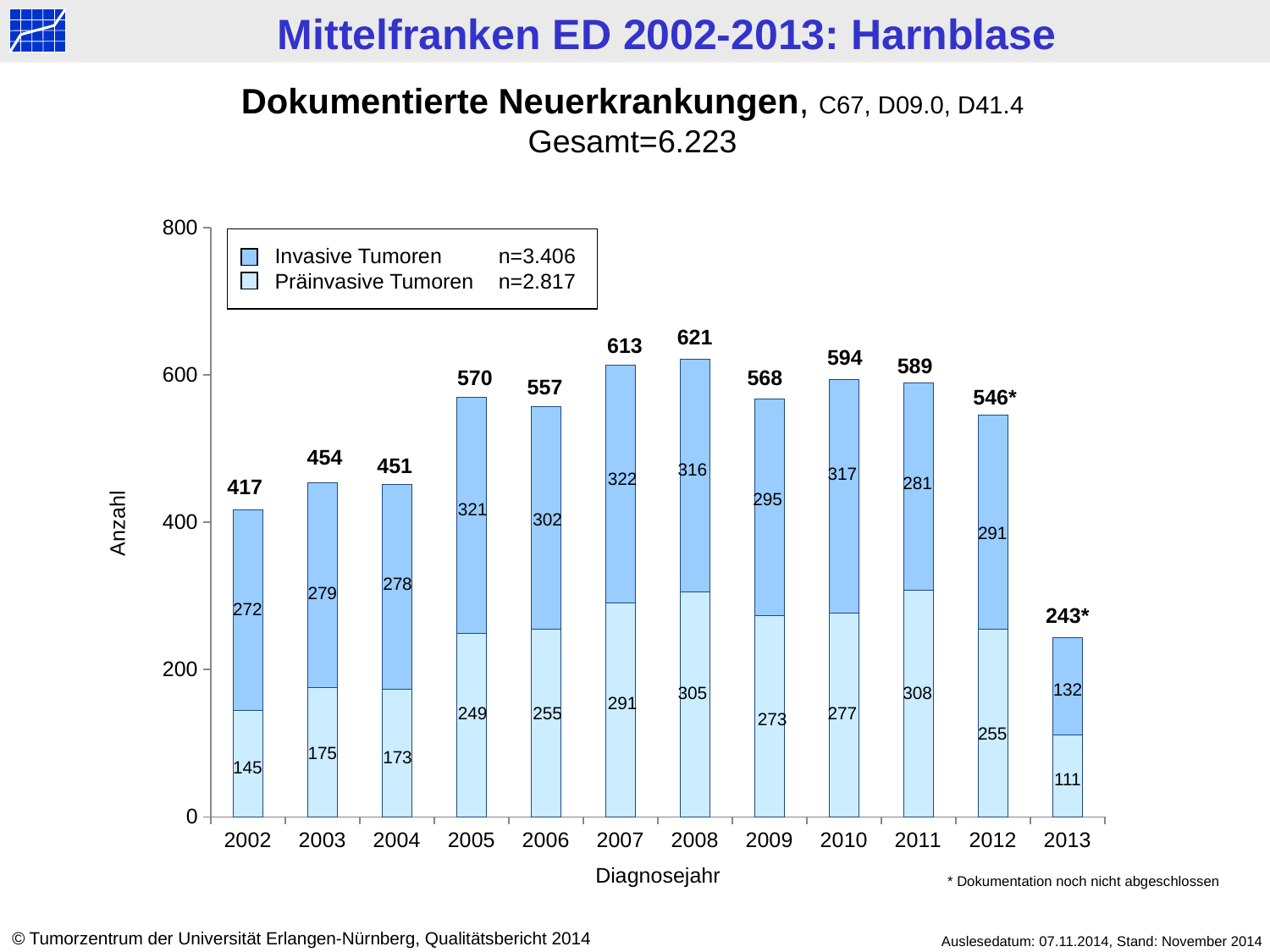
Which year has the highest total number of documented new cases? 2008 How many Präinvasive Tumoren are shown for 2011? 308 What is the difference between the total for 2007 and the total for 2006? 56 What kind of chart is shown on the slide? stacked bar chart According to the legend, what is the n value for Invasive Tumoren? n=3.406 How many Invasive Tumoren are shown for 2007? 322 How many series does the legend list? 2 What is the total number of documented new cases shown above the bar for 2008? 621 Which year has the lowest total number of documented new cases? 2013 How many diagnosis years are shown on the x axis? 12 Which is larger in 2011: the number of Invasive Tumoren or the number of Präinvasive Tumoren? Präinvasive Tumoren Is the total for 2005 greater or less than 600? less